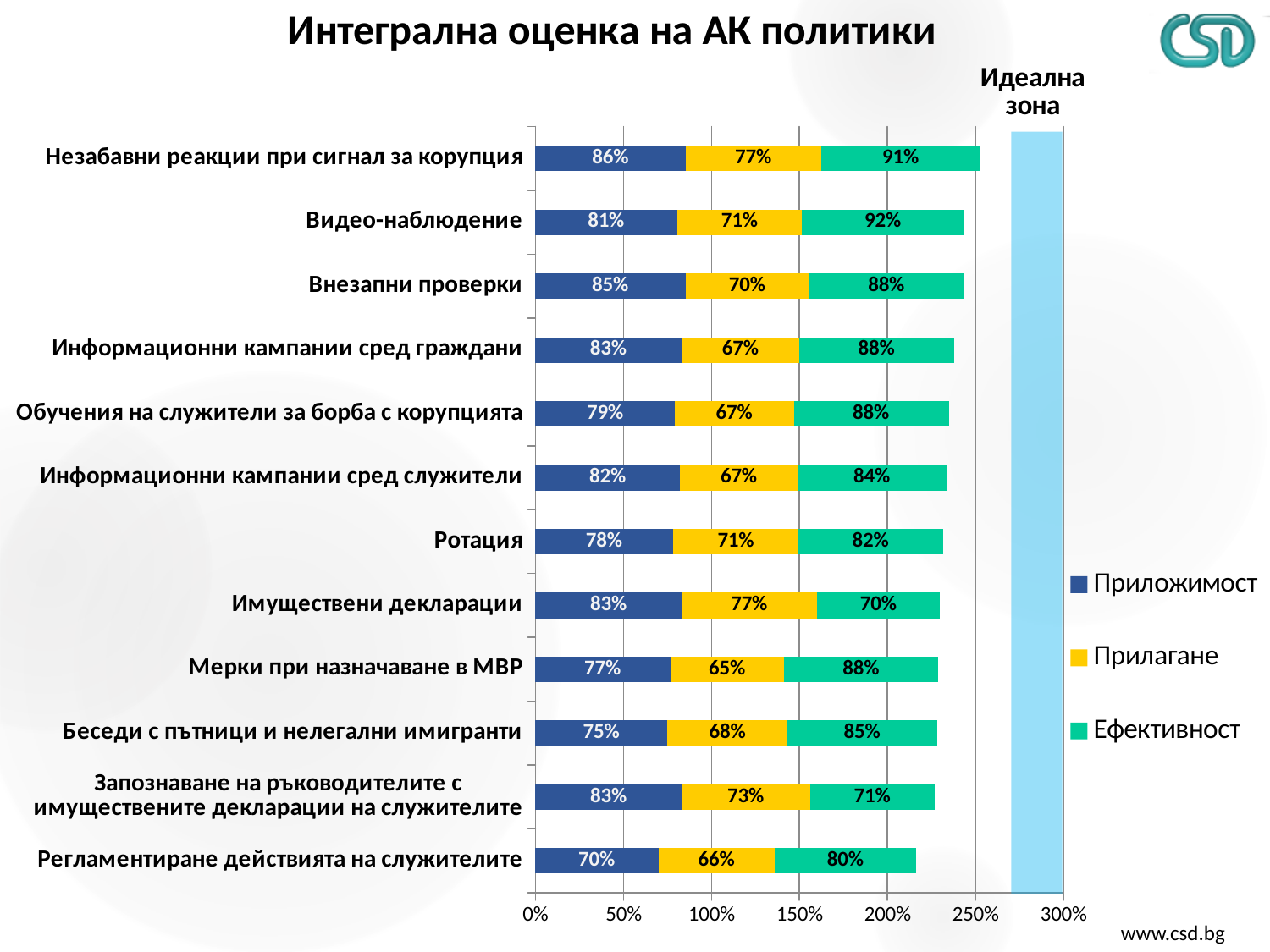
Which is larger for Внезапни проверки: the Приложимост value or the Прилагане value? Приложимост How many series does the legend list? 3 What is the Ефективност value for Имуществени декларации? 70% How many categories (policies) are plotted on the chart? 12 What is the Прилагане value for Мерки при назначаване в МВР? 65% What is the total of the stacked bar for Регламентиране действията на служителите? 216% Which category has the highest Приложимост value? Незабавни реакции при сигнал за корупция What is the difference between the Ефективност and Прилагане values for Ротация? 11% What type of chart is shown on the slide? Stacked bar chart Which category has the lowest Приложимост value? Регламентиране действията на служителите What is the Приложимост value for Видео-наблюдение? 81% Which category has the highest Ефективност value? Видео-наблюдение